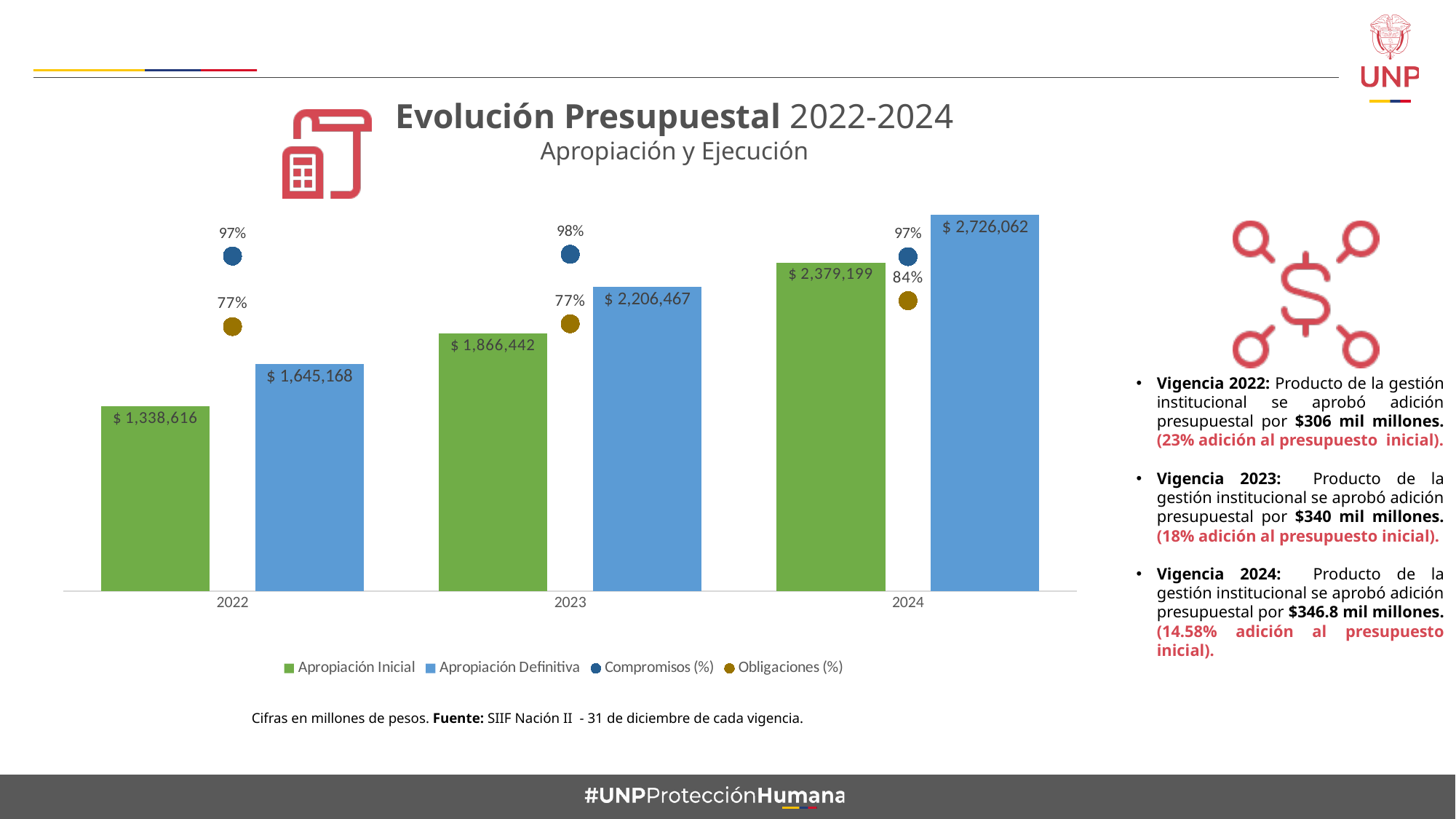
Which year has the lowest Apropiación Inicial? 2022 What is the Obligaciones (%) value for 2024? 84% What is the Apropiación Definitiva value for 2024? $ 2,726,062 How many series does the chart legend list? 4 Which year has the highest Apropiación Definitiva? 2024 Which is larger in 2023, Apropiación Inicial or Apropiación Definitiva? Apropiación Definitiva What is the difference between Apropiación Definitiva and Apropiación Inicial in 2024? $ 346,863 Does the Apropiación Inicial rise or fall from 2022 to 2024? Rise What kind of chart is used to show the Apropiación values? Bar chart What is the Apropiación Inicial value for 2022? $ 1,338,616 How many years are shown on the x axis of the chart? 3 What is the Compromisos (%) value for 2023? 98%